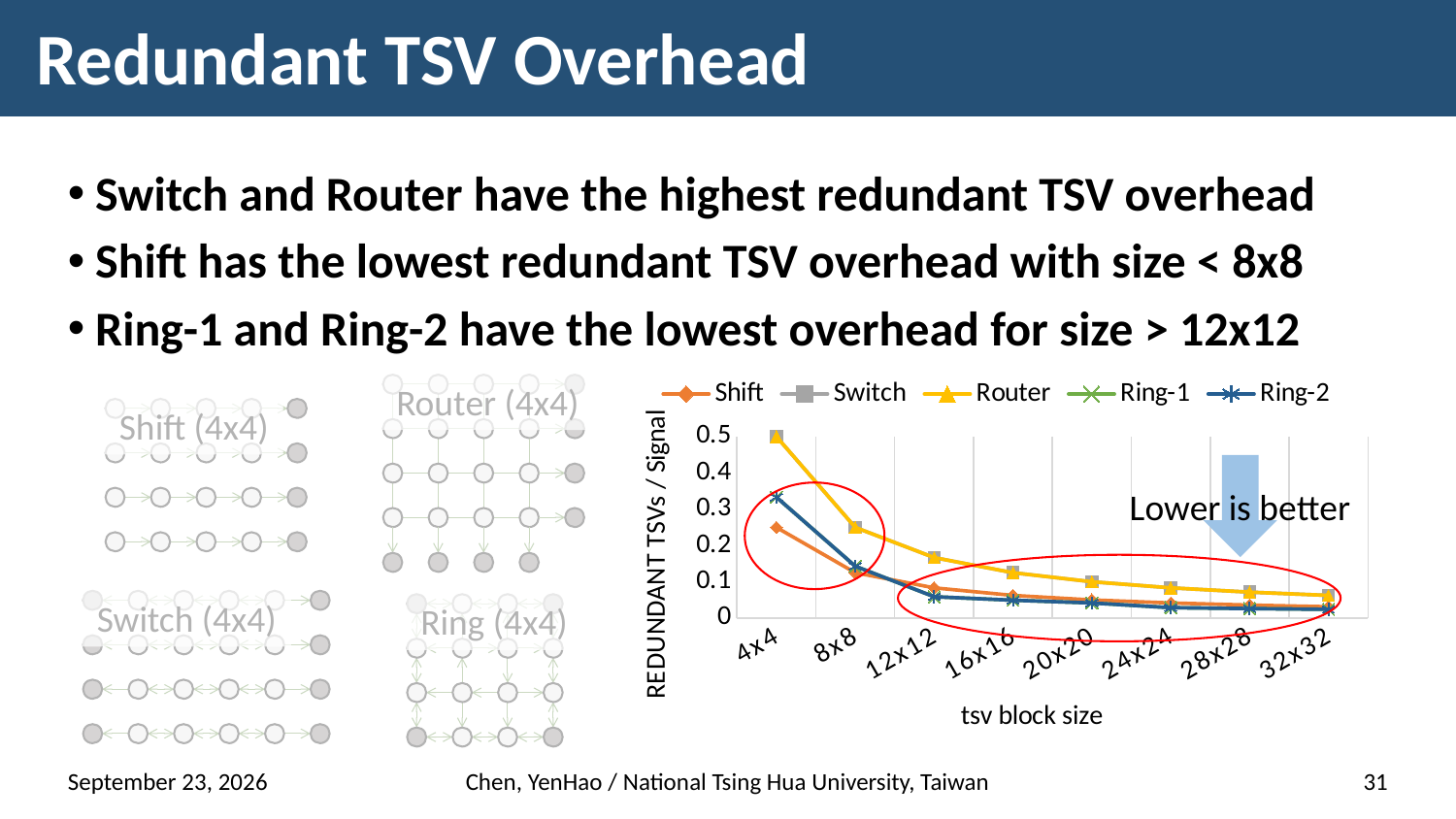
What kind of chart is shown on the slide? line chart Is the value for Ring-2 at 4x4 greater or less than 0.3? greater At 16x16, which is larger, the value for Router or the value for Ring-2? Router Is the value for Shift at 4x4 greater or less than 0.2? greater Which series has the lowest value at 4x4? Shift Is the value for Ring-1 at 12x12 greater or less than 0.1? less What is the title of the horizontal axis? tsv block size How many series does the chart legend list? 5 What is the title of the vertical axis? REDUNDANT TSVs / Signal Do the values for Router rise or fall as the tsv block size increases? fall How many tsv block sizes are plotted along the x axis? 8